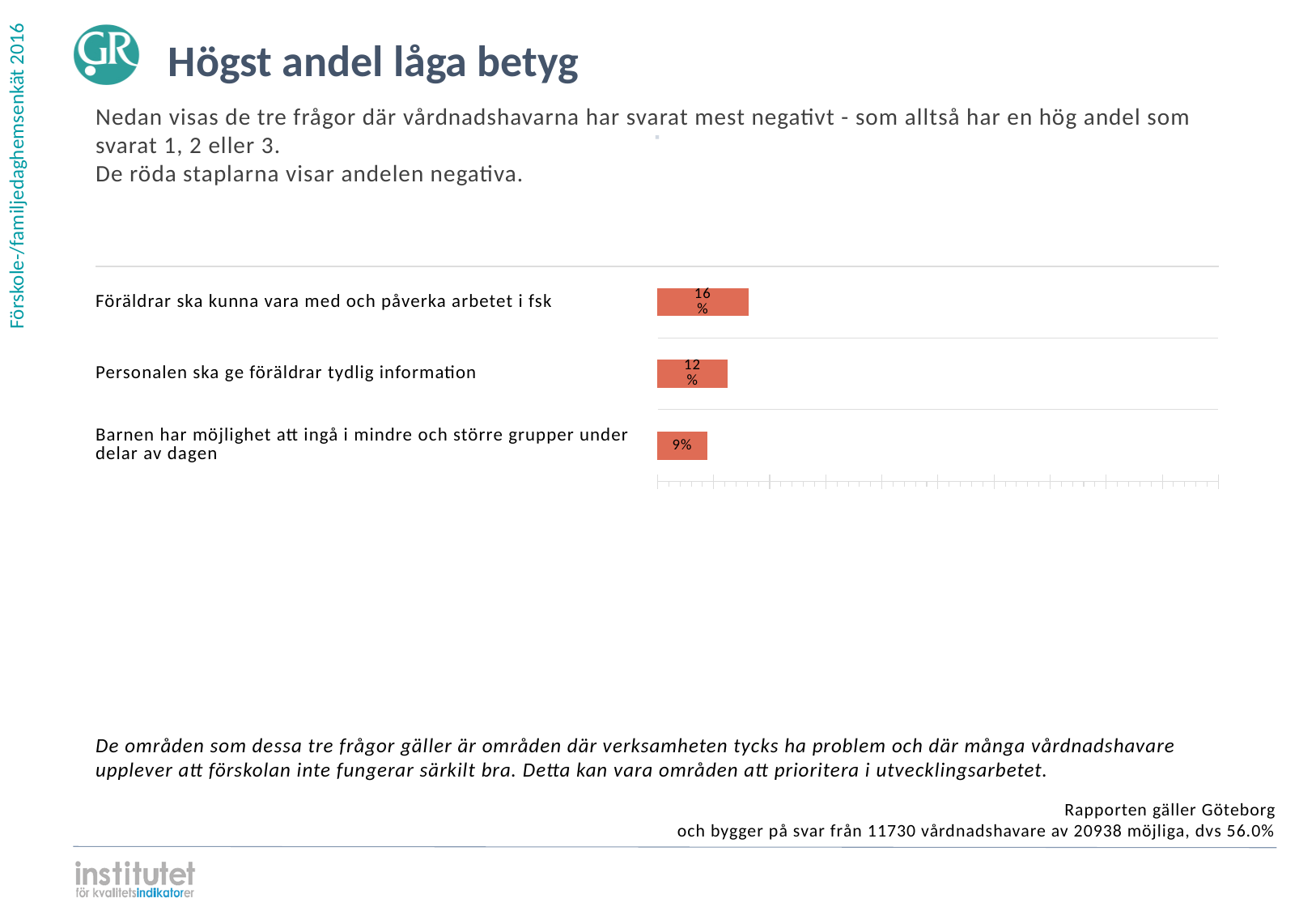
What kind of chart is shown on the slide? Bar chart What is the difference between the values for "Personalen ska ge föräldrar tydlig information" and "Barnen har möjlighet att ingå i mindre och större grupper under delar av dagen"? 3% What is the difference between the values for "Föräldrar ska kunna vara med och påverka arbetet i fsk" and "Personalen ska ge föräldrar tydlig information"? 4% What is the value for "Föräldrar ska kunna vara med och påverka arbetet i fsk"? 16% Which is larger: the value for "Personalen ska ge föräldrar tydlig information" or for "Barnen har möjlighet att ingå i mindre och större grupper under delar av dagen"? Personalen ska ge föräldrar tydlig information What is the value for "Barnen har möjlighet att ingå i mindre och större grupper under delar av dagen"? 9% Which category has the highest value? Föräldrar ska kunna vara med och påverka arbetet i fsk Which category has the lowest value? Barnen har möjlighet att ingå i mindre och större grupper under delar av dagen What is the value for "Personalen ska ge föräldrar tydlig information"? 12% What is the title of the slide containing the chart? Högst andel låga betyg What colour are the bars in the chart? Red How many categories are shown in the chart? 3